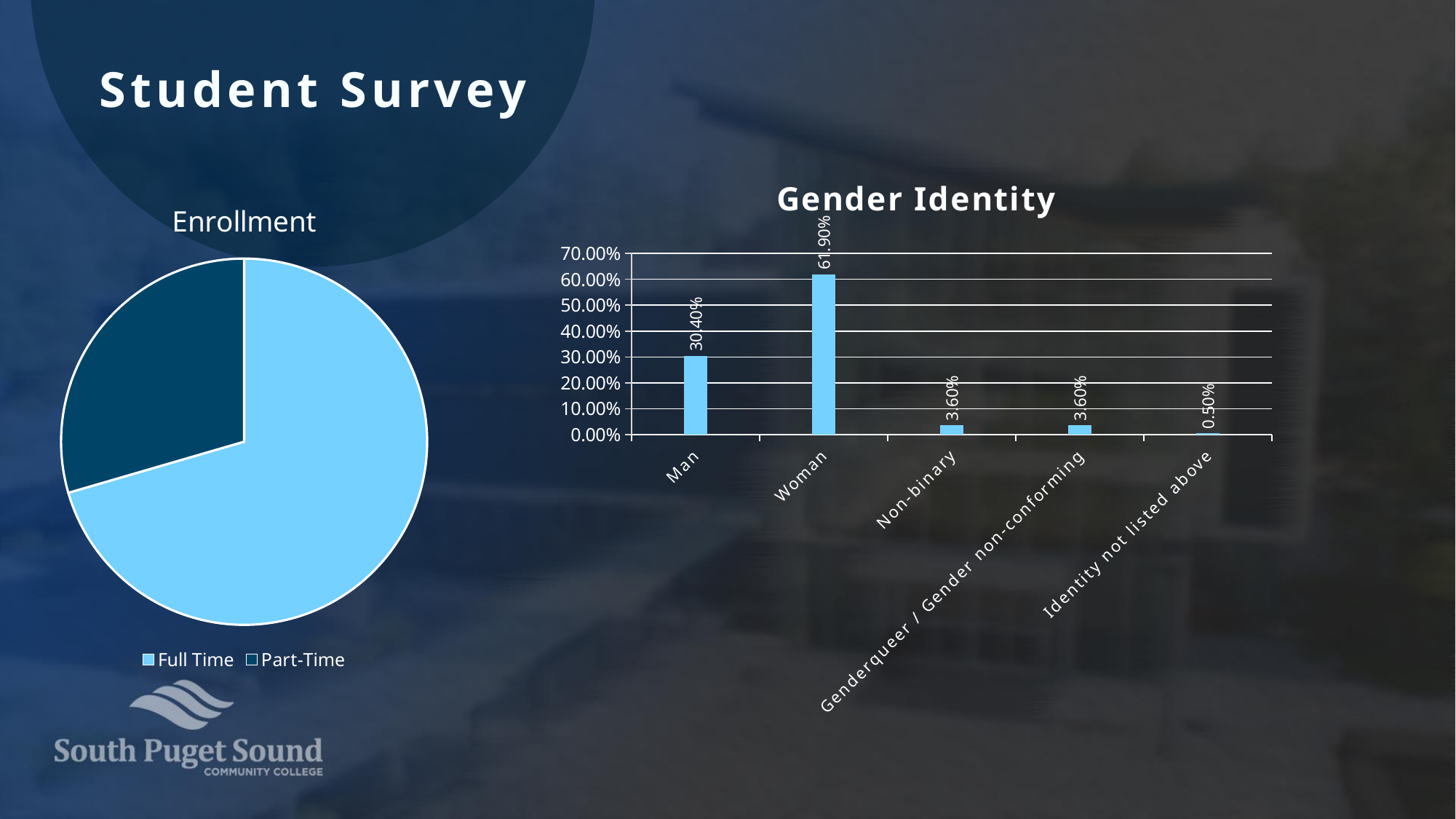
In the Gender Identity chart, which category has the lowest value? Identity not listed above In the Gender Identity chart, what is the value for Woman? 61.90% In the Gender Identity chart, which category has the highest value? Woman How many entries does the legend of the Enrollment chart list? 2 How many categories are shown in the Gender Identity chart? 5 In the Gender Identity chart, what is the difference between the values for Woman and Man? 31.50% In the Gender Identity chart, what is the value for Non-binary? 3.60% In the Gender Identity chart, what is the value for Man? 30.40% In the Gender Identity chart, is the value for Man greater or less than 40.00%? less In the Enrollment chart, which slice is larger, Full Time or Part-Time? Full Time What kind of chart is the Gender Identity chart? bar chart In the Gender Identity chart, what is the value for Identity not listed above? 0.50%